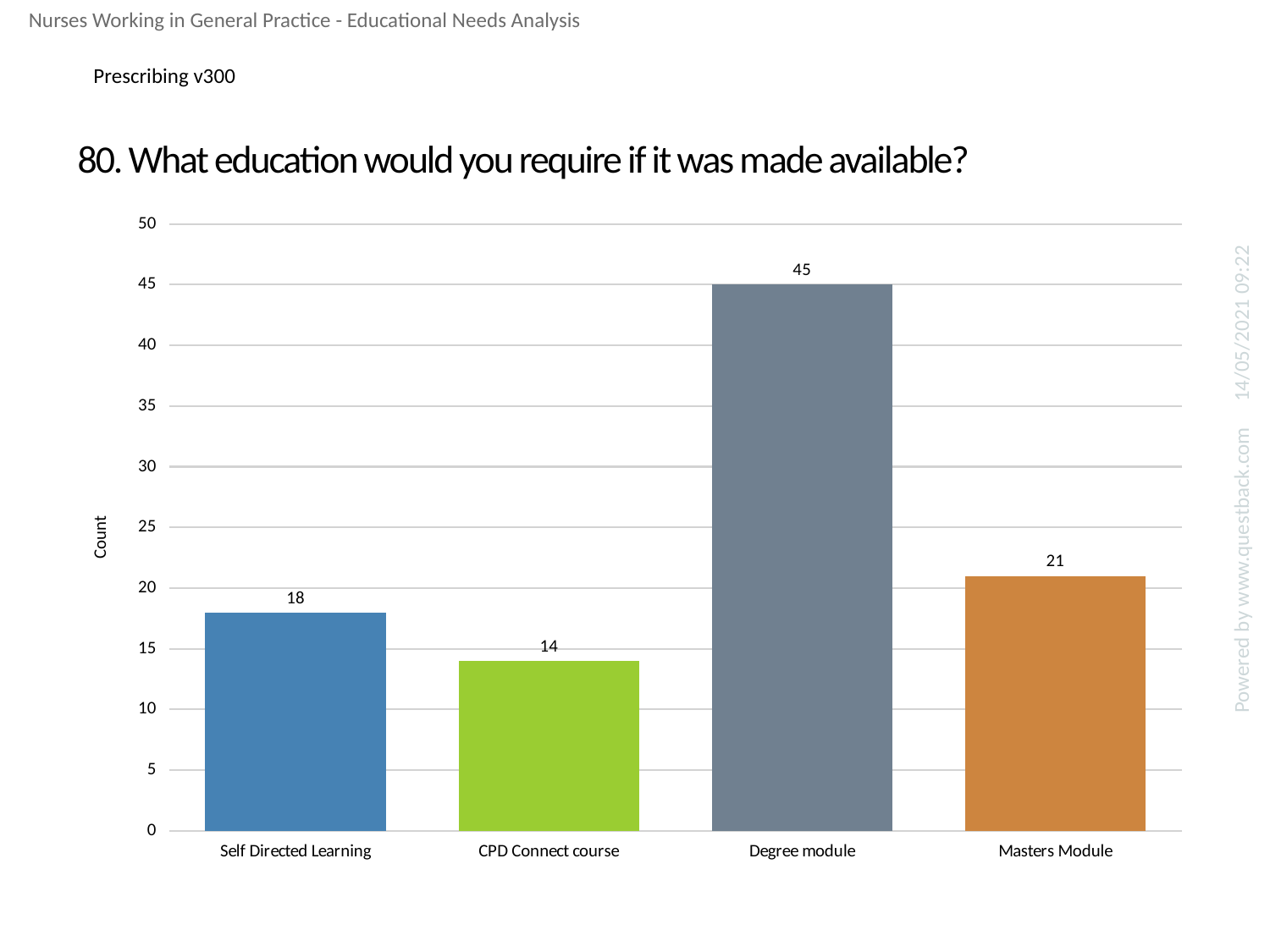
What is the label of the vertical axis? Count What kind of chart is shown on the slide? Bar chart What is the count for Masters Module? 21 Which category has the lowest count? CPD Connect course What is the count for Self Directed Learning? 18 Which category has the highest count? Degree module How many categories are shown on the chart? 4 What is the difference between the counts for Degree module and Masters Module? 24 What is the difference between the counts for Self Directed Learning and CPD Connect course? 4 What is the count for CPD Connect course? 14 What is the count for Degree module? 45 Which has a larger count, Masters Module or Self Directed Learning? Masters Module